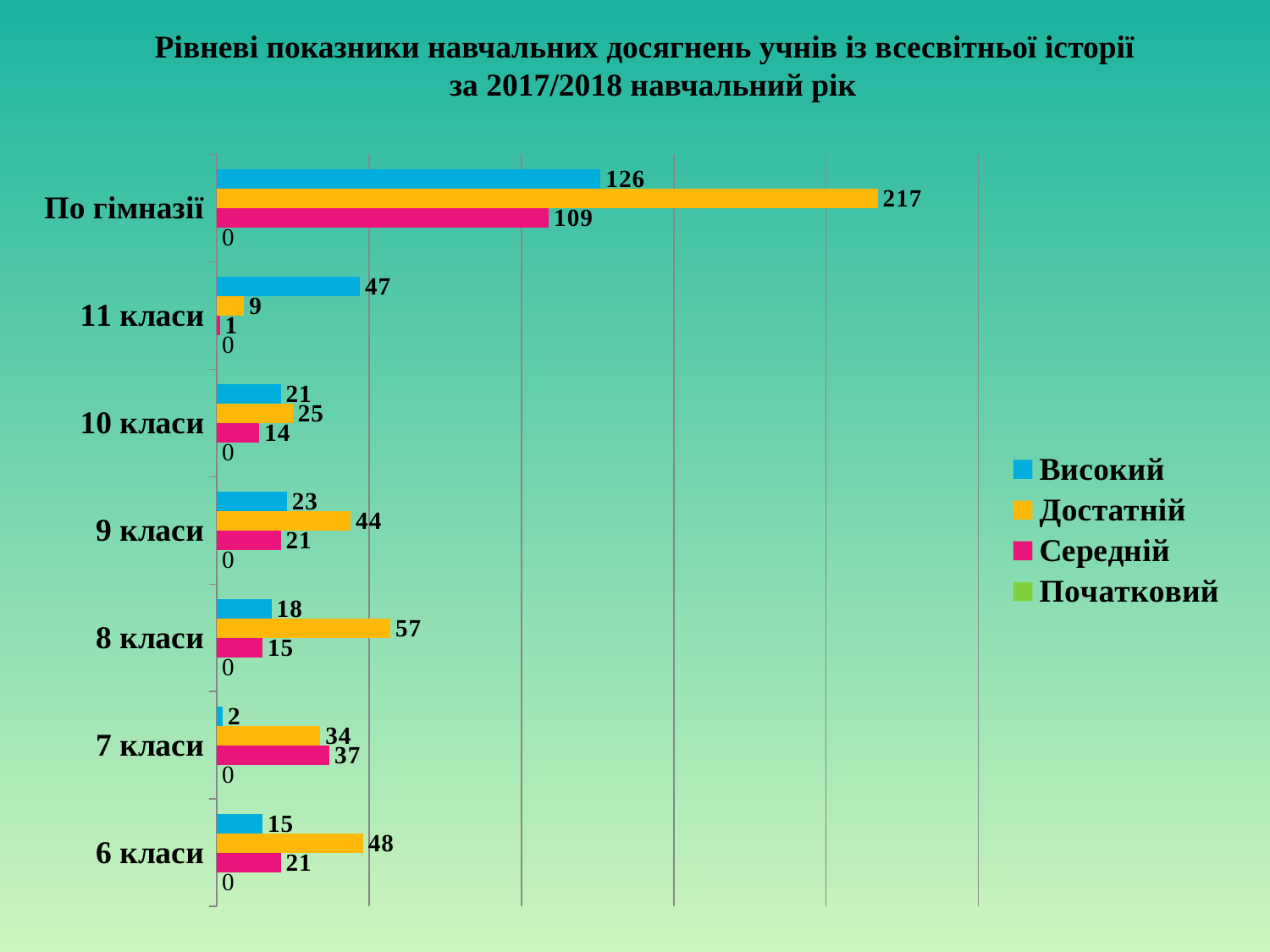
What kind of chart is shown on the slide? Bar chart What is the value for Початковий in the 9 класи category? 0 Which category has the lowest Високий value? 7 класи What is the value for Достатній in the По гімназії category? 217 Which colour represents the Середній series in the legend? Pink Among the class categories (excluding По гімназії), which has the highest Достатній value? 8 класи What is the difference between the Достатній and Високий values for По гімназії? 91 What is the value for Середній in the 7 класи category? 37 How many categories are shown on the vertical axis? 7 How many series does the legend list? 4 Which is larger for 10 класи: the Високий value or the Достатній value? Достатній What is the value for Високий in the 11 класи category? 47